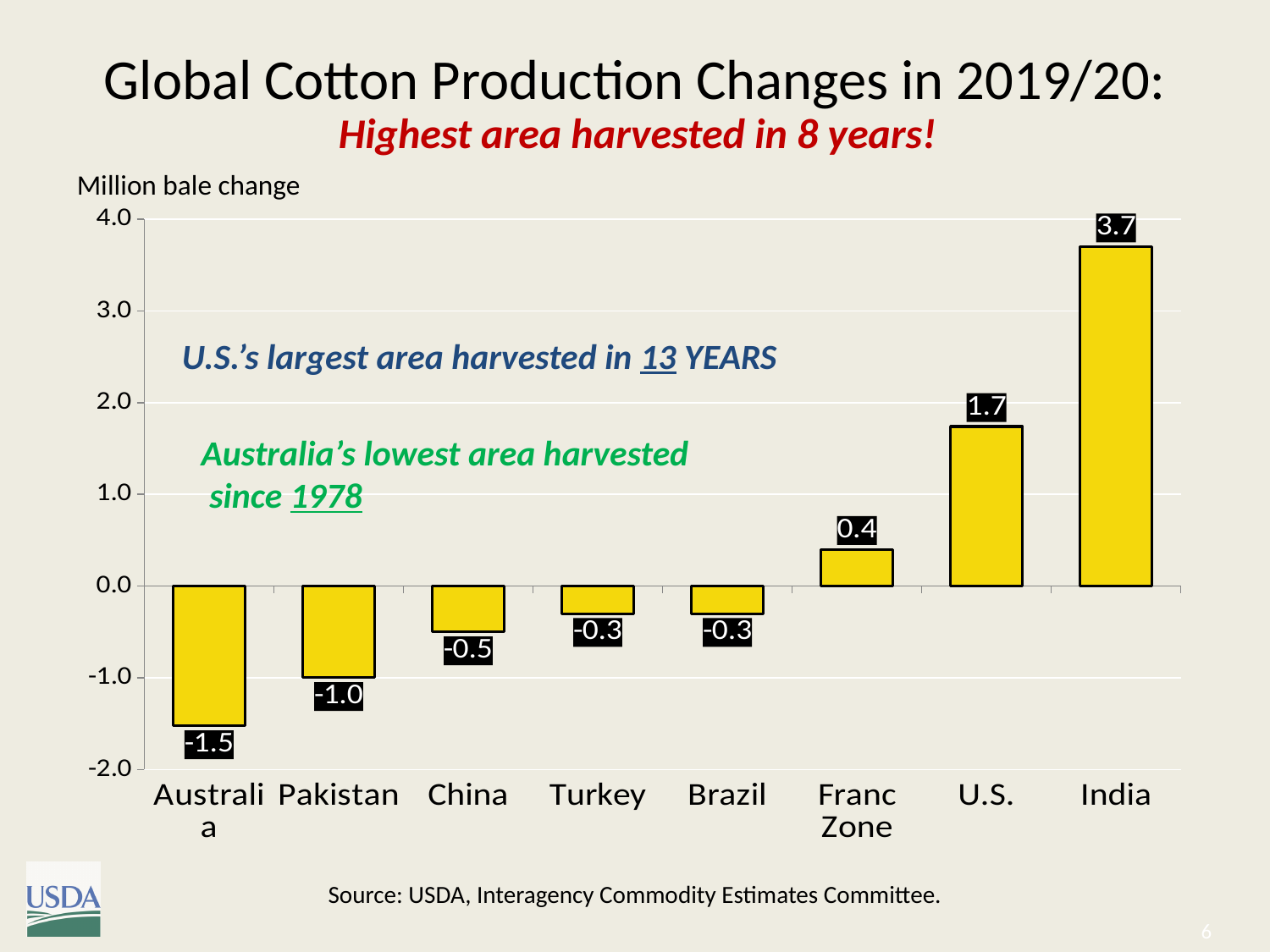
What is the million bale change for the U.S.? 1.7 What is the million bale change for the Franc Zone? 0.4 What is the million bale change for India? 3.7 Which country has the lowest million bale change? Australia What is the title of the chart on the slide? Global Cotton Production Changes in 2019/20: Highest area harvested in 8 years! What is the difference between the million bale change for India and the U.S.? 2.0 Do the values rise or fall moving from left to right along the x axis? Rise What is the million bale change for Australia? -1.5 How many countries or regions are shown on the chart? 8 Which country has the highest million bale change? India What kind of chart is shown on the slide? Bar chart Which has a larger million bale change, Pakistan or China? China